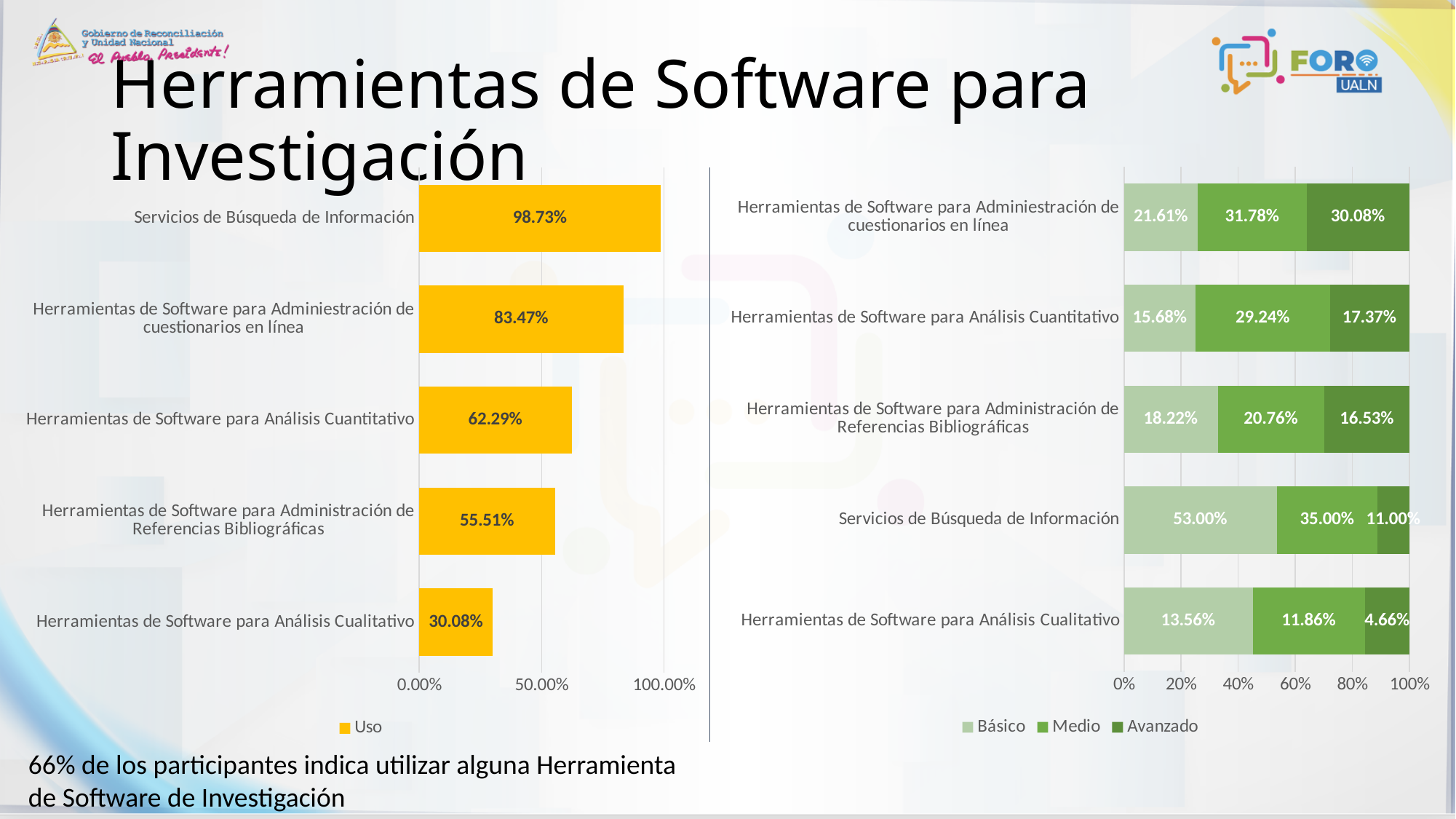
In the left chart (Uso), what is the value for Servicios de Búsqueda de Información? 98.73% In the left chart (Uso), what is the value for Herramientas de Software para Análisis Cualitativo? 30.08% In the right chart, which category has the highest Básico value? Servicios de Búsqueda de Información In the left chart (Uso), which category has the lowest value? Herramientas de Software para Análisis Cualitativo In the right chart, how many series does the legend list? 3 In the right chart, what is the Avanzado value for Herramientas de Software para Análisis Cuantitativo? 17.37% What kind of chart is the left chart (Uso)? Bar chart In the left chart (Uso), what is the difference between Servicios de Búsqueda de Información and Herramientas de Software para Administración de cuestionarios en línea? 15.26% In the left chart (Uso), how many categories are shown? 5 In the right chart, what is the Medio value for Servicios de Búsqueda de Información? 35.00% In the right chart, which is larger for Herramientas de Software para Administración de cuestionarios en línea: the Básico value or the Medio value? Medio In the right chart, what is the total of the stacked bar for Herramientas de Software para Análisis Cualitativo? 30.08%